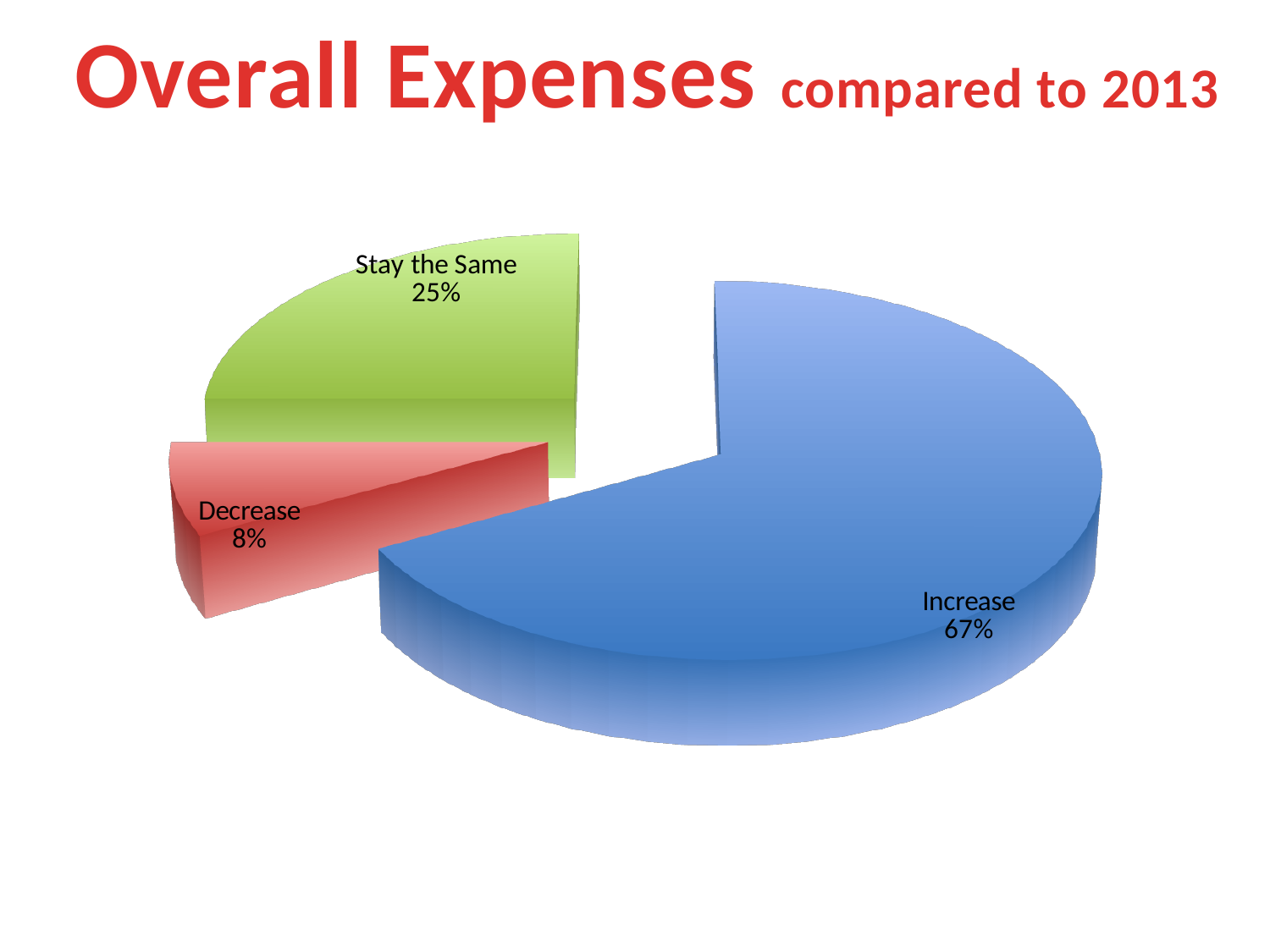
What colour is the Increase slice? blue What kind of chart is shown on the slide? pie chart Which slice of the pie is the smallest? Decrease What percentage of the pie is labelled Increase? 67% Which is larger, the Stay the Same slice or the Decrease slice? Stay the Same Which slice of the pie is the largest? Increase What is the difference in percentage points between the Increase slice and the Stay the Same slice? 42 How many slices does the pie chart have? 3 What percentage of the pie is labelled Stay the Same? 25% What percentage of the pie is labelled Decrease? 8% What is the difference in percentage points between the Stay the Same slice and the Decrease slice? 17 What is the title of the slide containing the pie chart? Overall Expenses compared to 2013